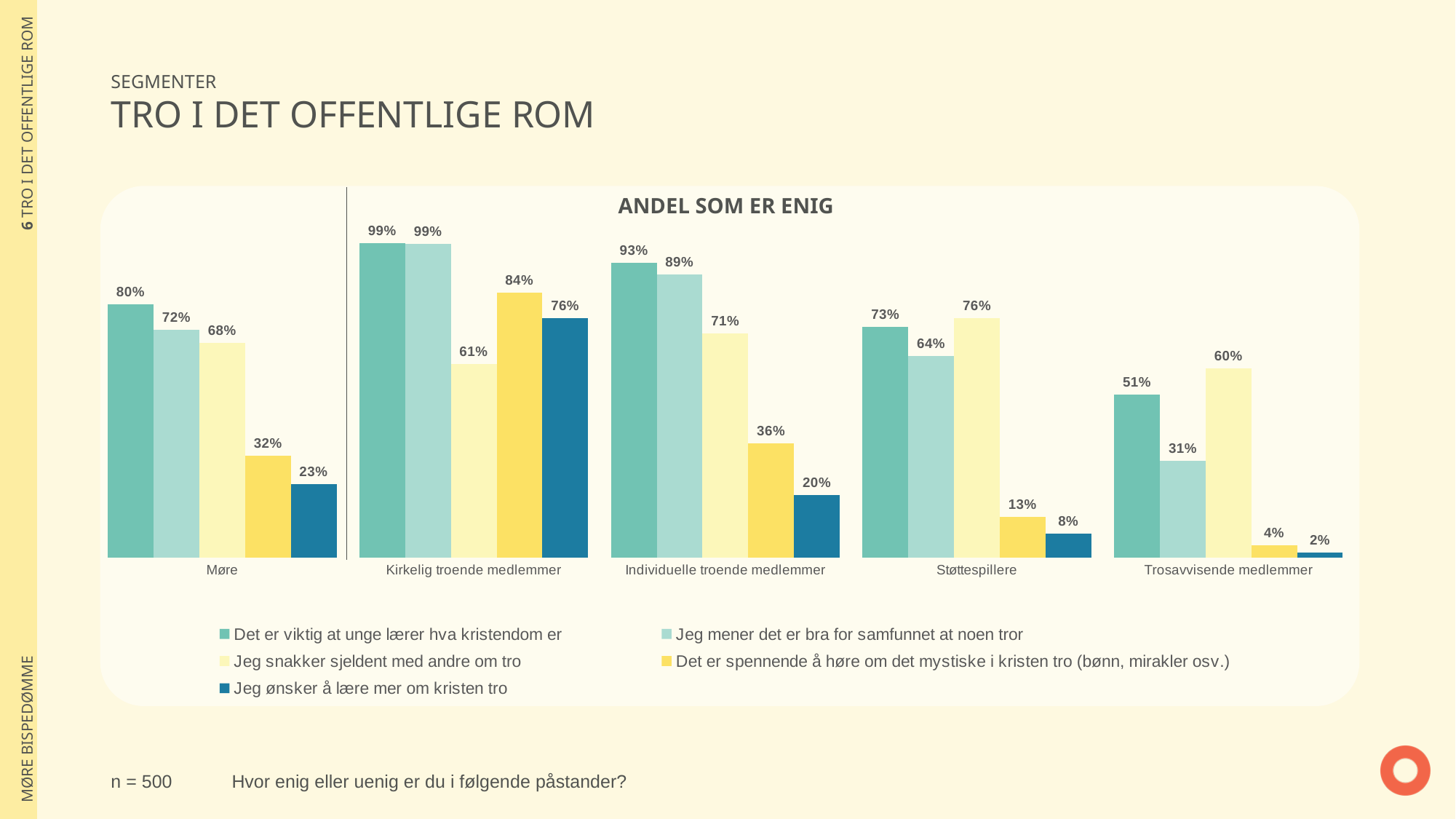
What kind of chart is shown on the slide? Bar chart What is the title of the chart? ANDEL SOM ER ENIG Which category has the lowest value for "Jeg ønsker å lære mer om kristen tro"? Trosavvisende medlemmer How many categories (segments) are shown on the x axis? 5 How many series does the legend list? 5 Which category has the highest value for "Det er viktig at unge lærer hva kristendom er"? Kirkelig troende medlemmer Among Støttespillere, which is larger: "Jeg snakker sjeldent med andre om tro" or "Det er viktig at unge lærer hva kristendom er"? Jeg snakker sjeldent med andre om tro Does the value for "Jeg mener det er bra for samfunnet at noen tror" rise or fall from Kirkelig troende medlemmer to Trosavvisende medlemmer? Fall What is the value for "Jeg ønsker å lære mer om kristen tro" in the Møre group? 23% What is the difference between "Det er viktig at unge lærer hva kristendom er" and "Jeg ønsker å lære mer om kristen tro" among Individuelle troende medlemmer? 73 percentage points What is the value for "Jeg snakker sjeldent med andre om tro" among Kirkelig troende medlemmer? 61% What is the value for "Det er spennende å høre om det mystiske i kristen tro (bønn, mirakler osv.)" among Trosavvisende medlemmer? 4%